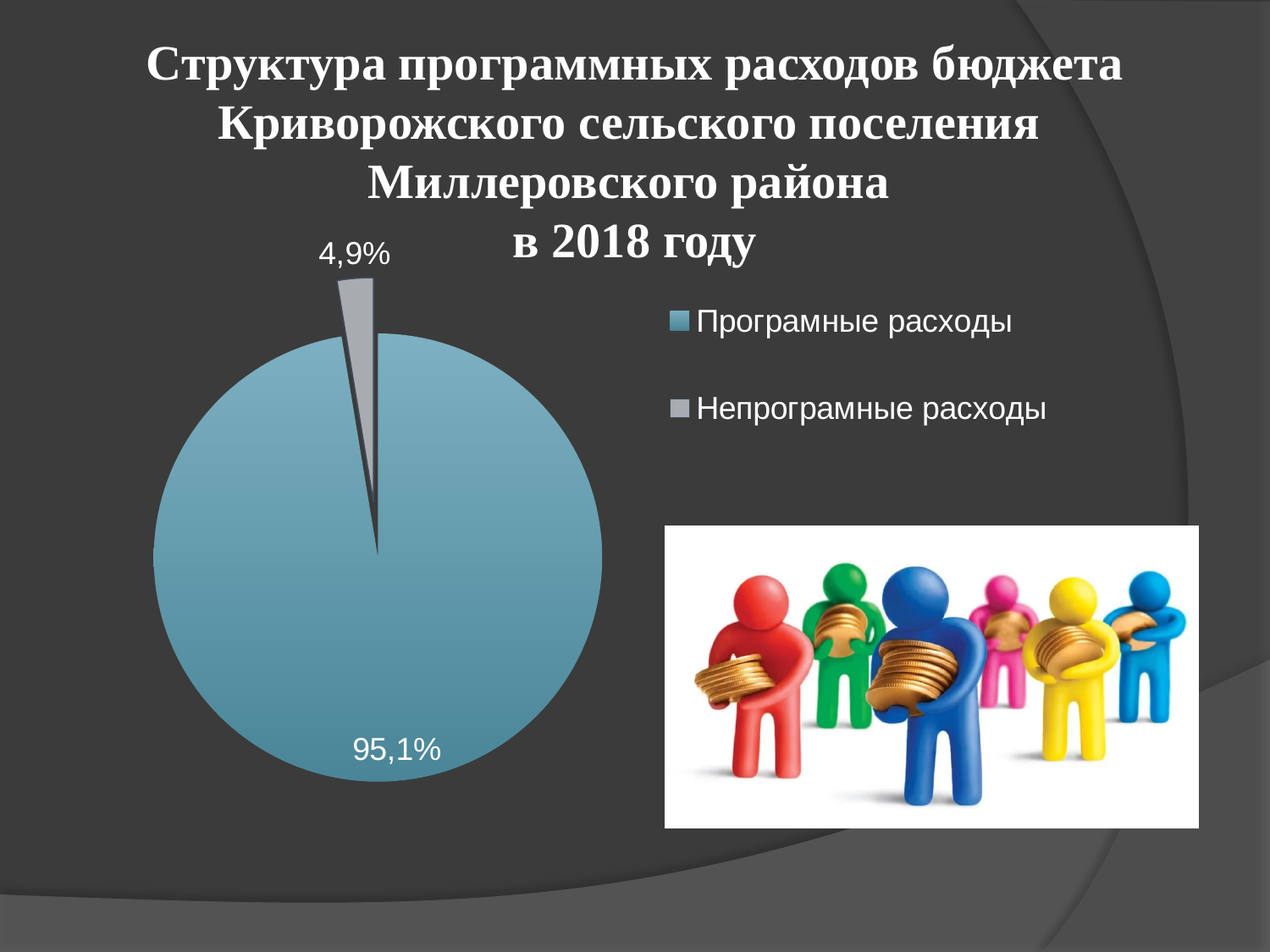
How many slices does the pie chart have? 2 What kind of chart is shown on the slide? pie chart Which category has the largest share of the pie? Програмные расходы What is the value for Непрограмные расходы? 4,9% Which is larger: Програмные расходы or Непрограмные расходы? Програмные расходы What is the difference between the shares of Програмные расходы and Непрограмные расходы? 90,2% What colour is the slice for Непрограмные расходы? grey Which category has the smallest share of the pie? Непрограмные расходы Which year does the chart title refer to? 2018 How many entries does the legend list? 2 What is the value for Програмные расходы? 95,1%